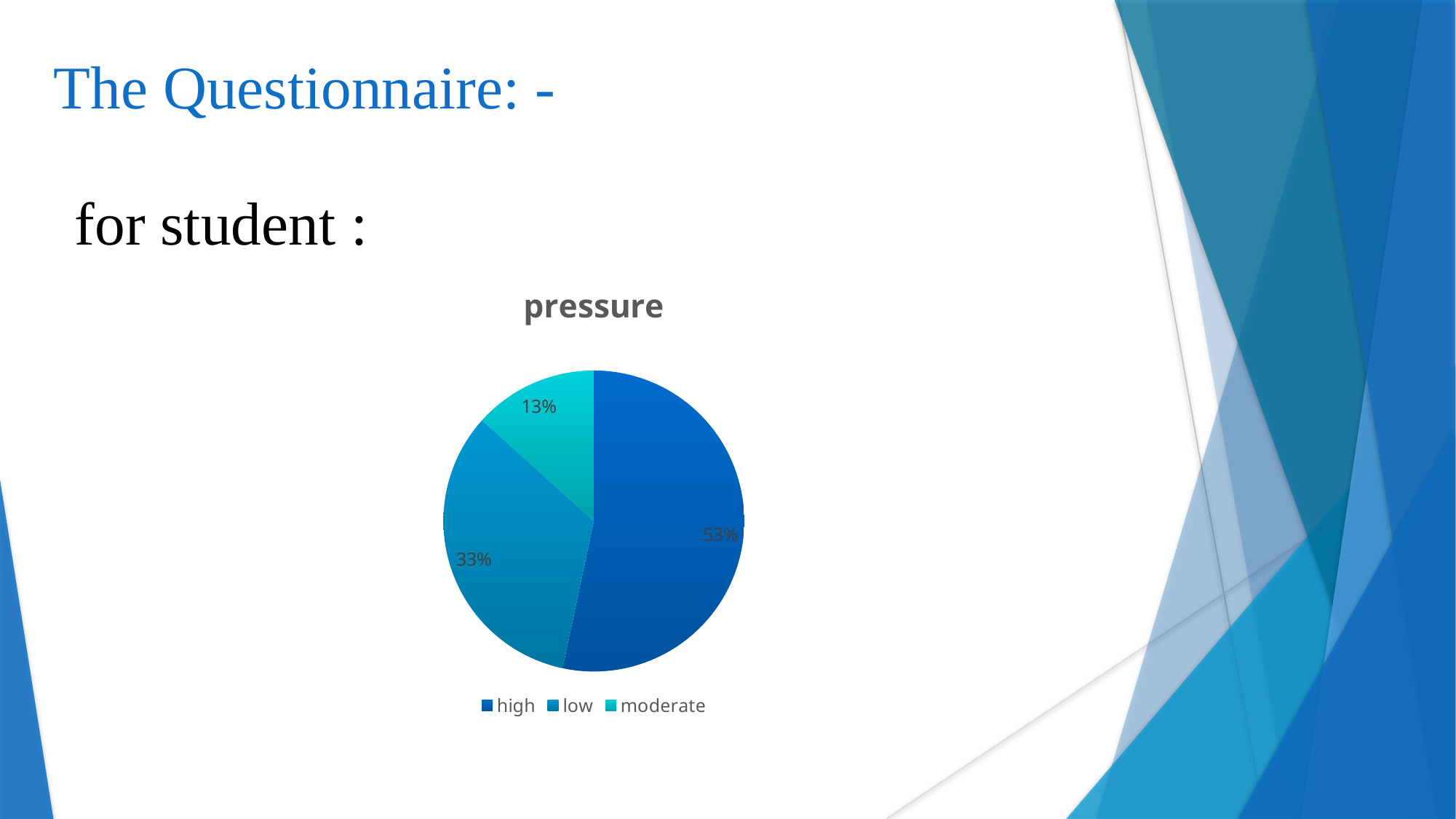
What share of the pie does the 'high' slice represent? 53% What kind of chart is shown on the slide? pie chart What is the title of the chart? pressure What is the difference in percentage points between the 'low' and 'moderate' slices? 20 What share of the pie does the 'moderate' slice represent? 13% Which category has the largest slice of the pie? high Which is larger, the 'low' slice or the 'moderate' slice? low What share of the pie does the 'low' slice represent? 33% How many entries does the legend list? 3 How many categories does the pie chart have? 3 Which category has the smallest slice of the pie? moderate What is the difference in percentage points between the 'high' and 'low' slices? 20